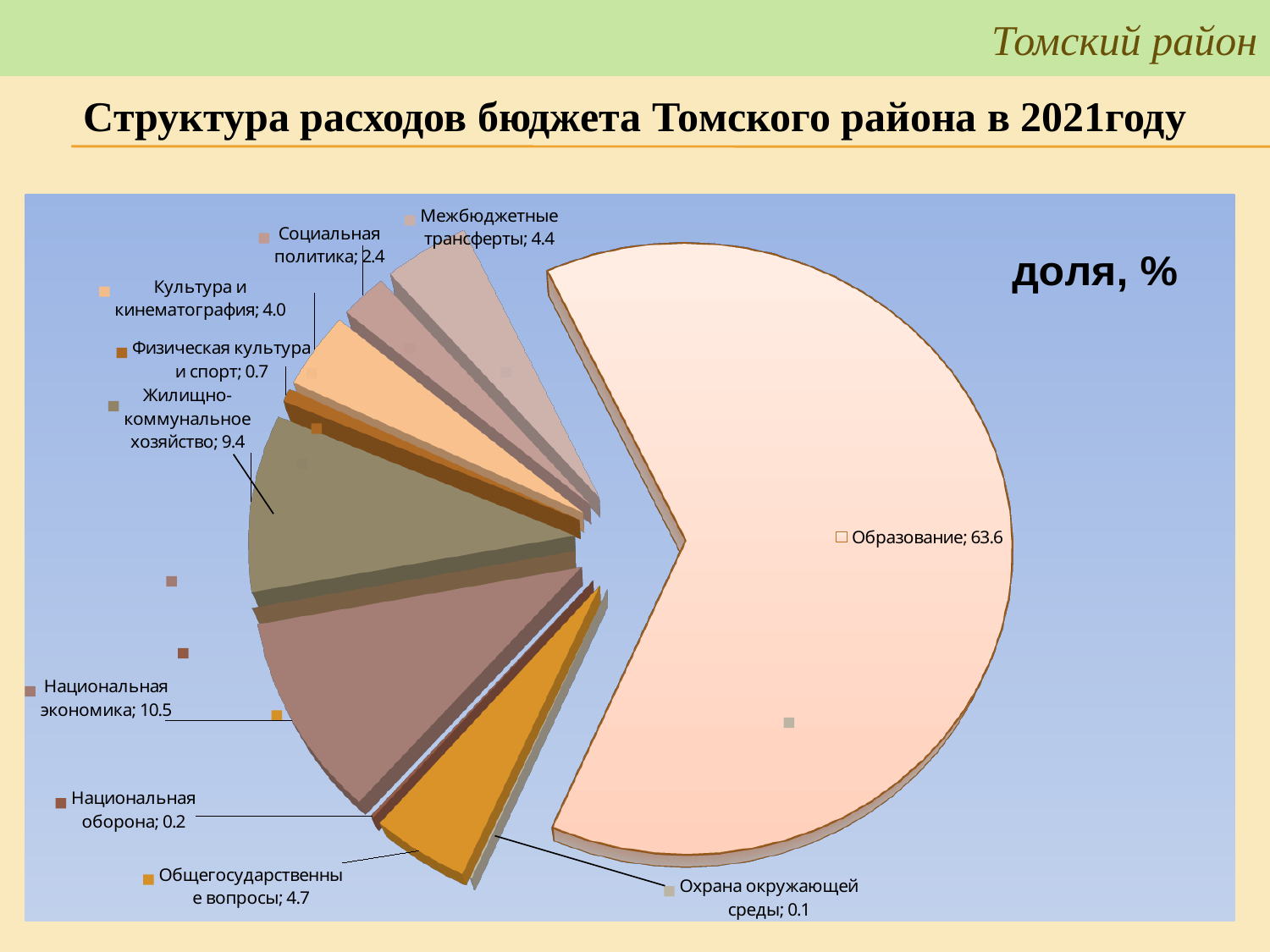
What share does Образование have in the pie chart? 63.6 What is the value shown for Национальная экономика? 10.5 Which category has the largest slice of the pie? Образование What is the value for Межбюджетные трансферты? 4.4 What is the title of the chart on the slide? доля, % How many slices in the pie chart have data labels? 10 What is the difference between the values for Национальная экономика and Жилищно-коммунальное хозяйство? 1.1 Which is larger: Общегосударственные вопросы or Культура и кинематография? Общегосударственные вопросы What unit label is printed in the upper right of the chart area? доля, % What value is labelled for Жилищно-коммунальное хозяйство? 9.4 What type of chart is shown on the slide? Pie chart